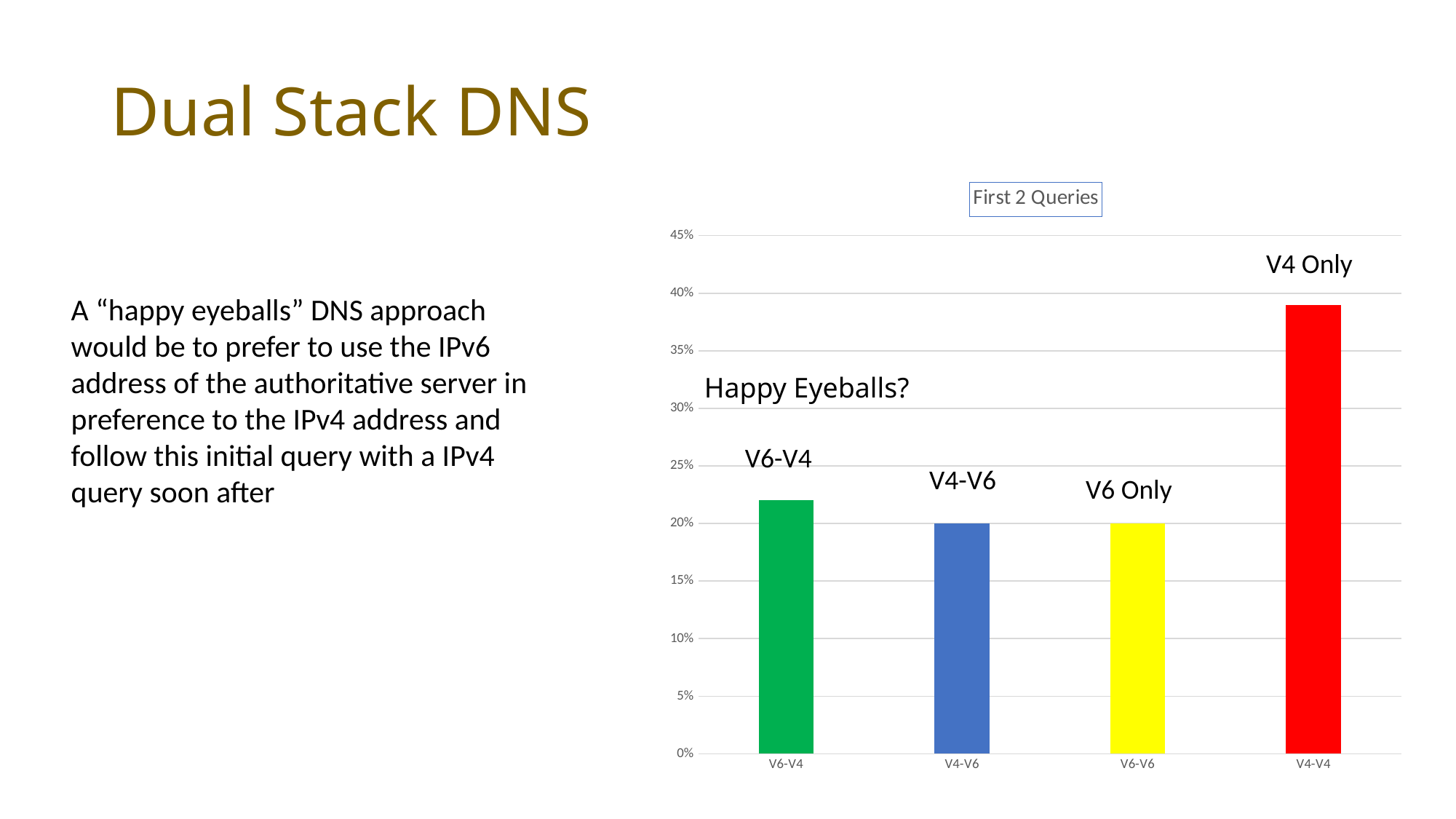
Is the value for V6-V4 greater or less than 20%? greater Which category has the highest bar in the chart? V4-V4 Is the value for V4-V4 greater or less than 40%? less What is the title of the chart? First 2 Queries What value does the V4-V6 bar reach on the y axis? 20% Is the value for V6-V4 greater or less than 25%? less How many categories are plotted on the x axis of the chart? 4 What colour is the V4-V4 bar? red Which is larger, the value for V6-V4 or the value for V4-V6? V6-V4 What value does the V6-V6 bar reach on the y axis? 20% What kind of chart is shown on the slide? bar chart